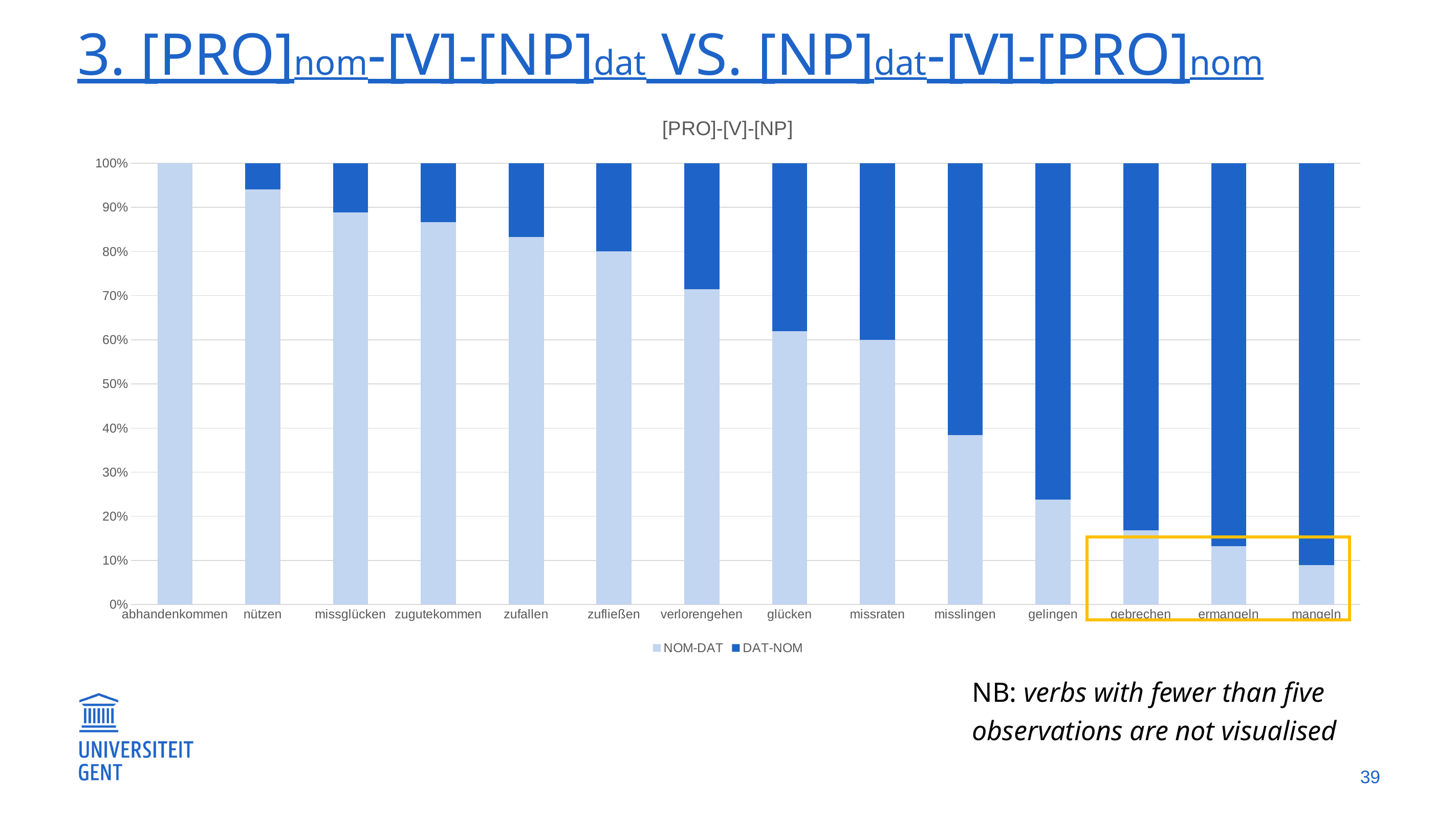
Which verb has the lowest NOM-DAT share? mangeln What is the title of the chart? [PRO]-[V]-[NP] How many series does the chart's legend list? 2 Which verb has the highest NOM-DAT share? abhandenkommen What is the NOM-DAT share for abhandenkommen? 100% Does the NOM-DAT share rise or fall moving from left to right along the x axis? fall Which verb has the larger NOM-DAT share, nützen or missglücken? nützen Is the NOM-DAT share for gelingen greater or less than 30%? less What kind of chart is shown on the slide? bar chart How many verbs (categories) are shown on the x axis of the chart? 14 Is the NOM-DAT share for glücken greater or less than 50%? greater Which series is shown in light blue in the chart? NOM-DAT